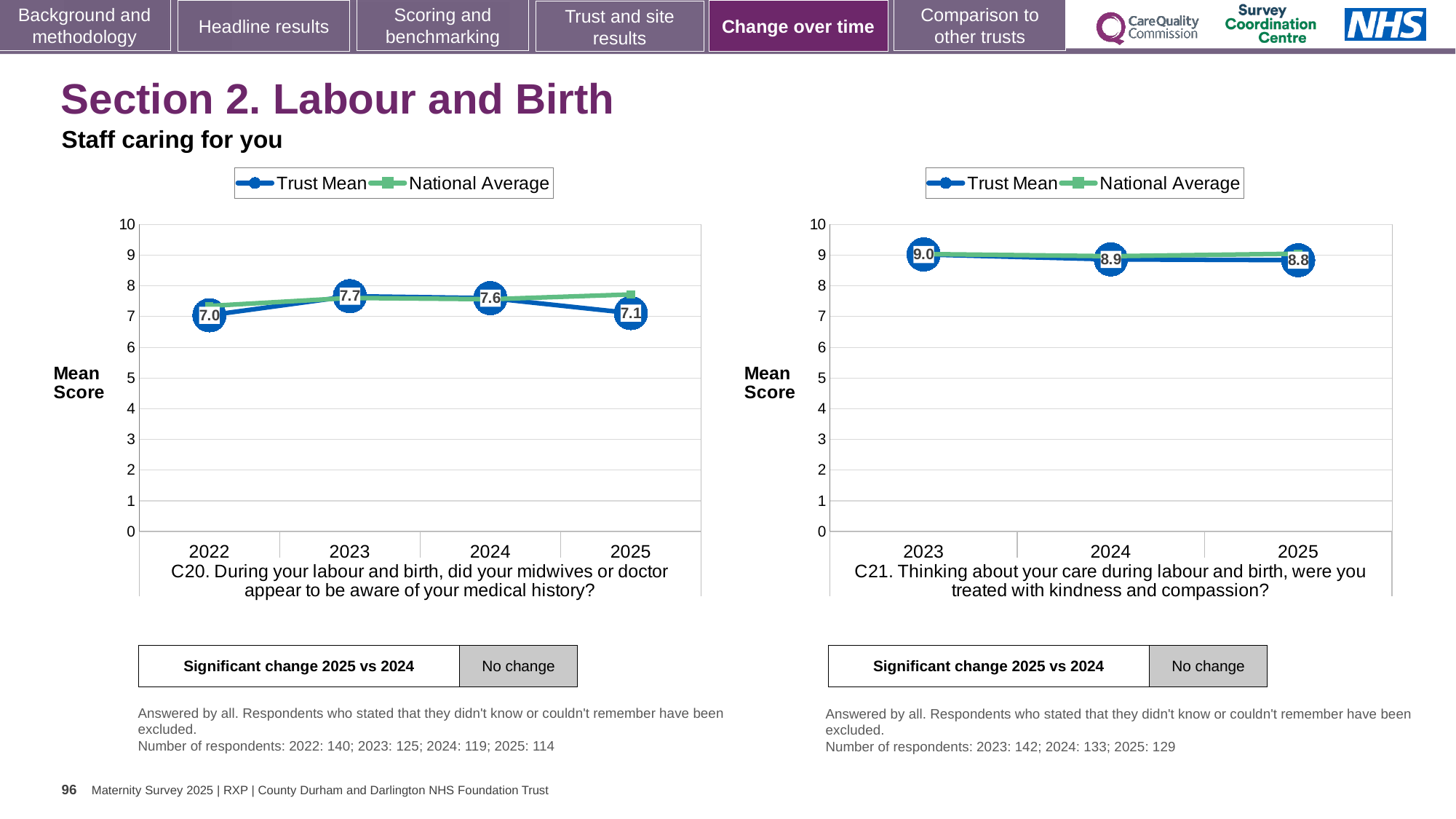
In the right chart (C21), what is the Trust Mean for 2025? 8.8 In the right chart (C21), does the Trust Mean rise or fall from 2023 to 2025? fall In the left chart (C20), which year has the highest Trust Mean? 2023 In the left chart (C20), what is the Trust Mean for 2025? 7.1 In the left chart (C20), what is the difference between the Trust Mean for 2023 and 2022? 0.7 In the right chart (C21), is the Trust Mean for 2023 greater or less than 8? greater In the left chart (C20), which year has the lowest Trust Mean? 2022 How many series does the legend of the right chart (C21) list? 2 In the left chart (C20), what is the Trust Mean for 2023? 7.7 In the right chart (C21), what is the difference between the Trust Mean for 2023 and 2025? 0.2 In the right chart (C21), what is the Trust Mean for 2023? 9.0 How many years are shown on the x axis of the left chart (C20)? 4